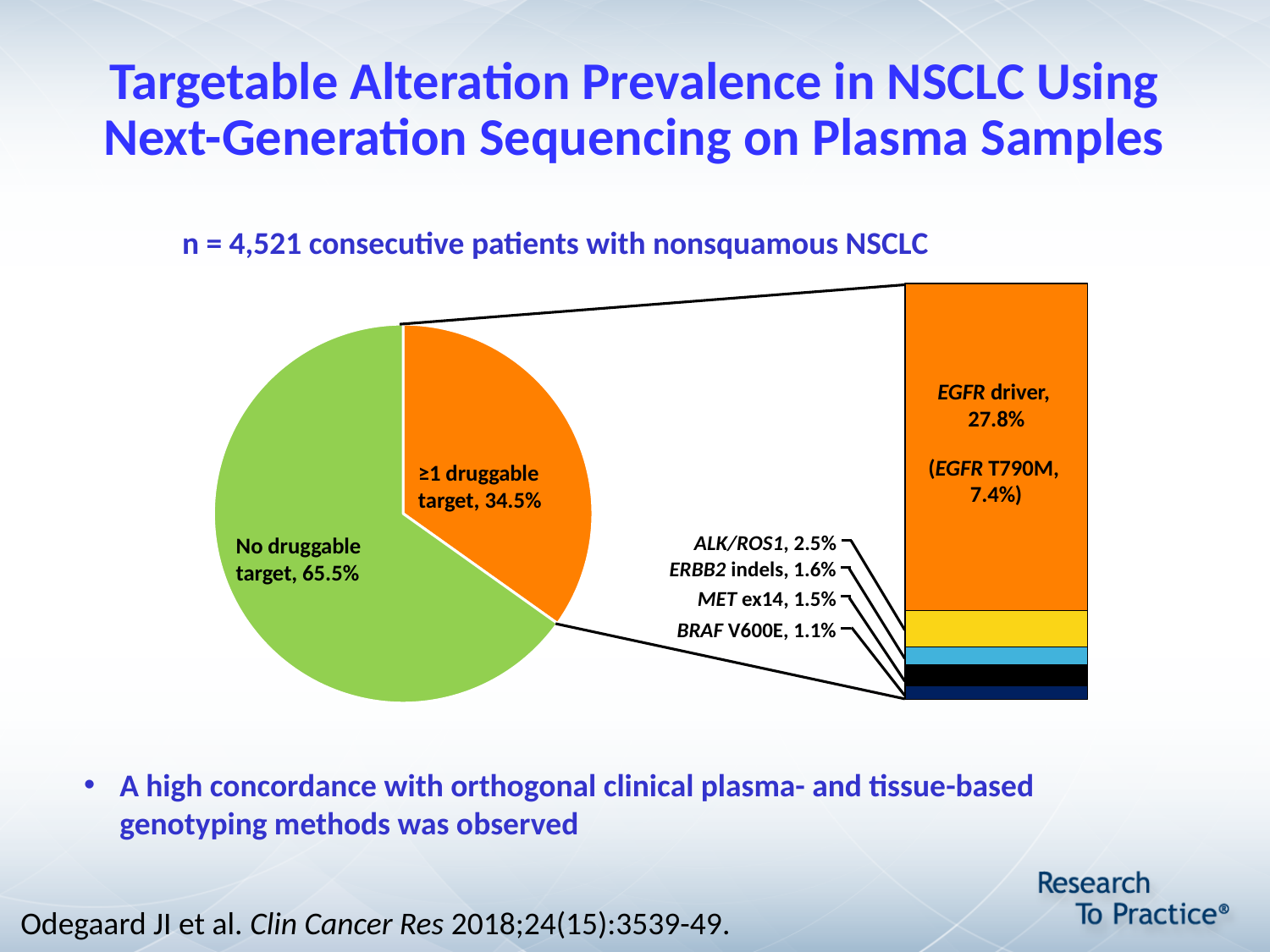
In the stacked bar breakdown, what is the prevalence of EGFR T790M? 7.4% What is the difference in percentage points between patients with no druggable target and those with ≥1 druggable target? 31 percentage points In the stacked bar breakdown, what is the prevalence of ALK/ROS1 alterations? 2.5% In the stacked bar breakdown, what is the prevalence of BRAF V600E? 1.1% What percentage of patients had no druggable target according to the pie chart? 65.5% In the stacked bar breakdown, what is the prevalence of EGFR driver alterations? 27.8% What percentage of patients had ≥1 druggable target according to the pie chart? 34.5% Which druggable target in the stacked bar breakdown has the lowest prevalence? BRAF V600E How many slices does the pie chart have? 2 Which is larger in the stacked bar breakdown: ERBB2 indels or MET ex14? ERBB2 indels Which druggable target in the stacked bar breakdown has the highest prevalence? EGFR driver How many patients are included in the analysis shown on the slide? 4,521